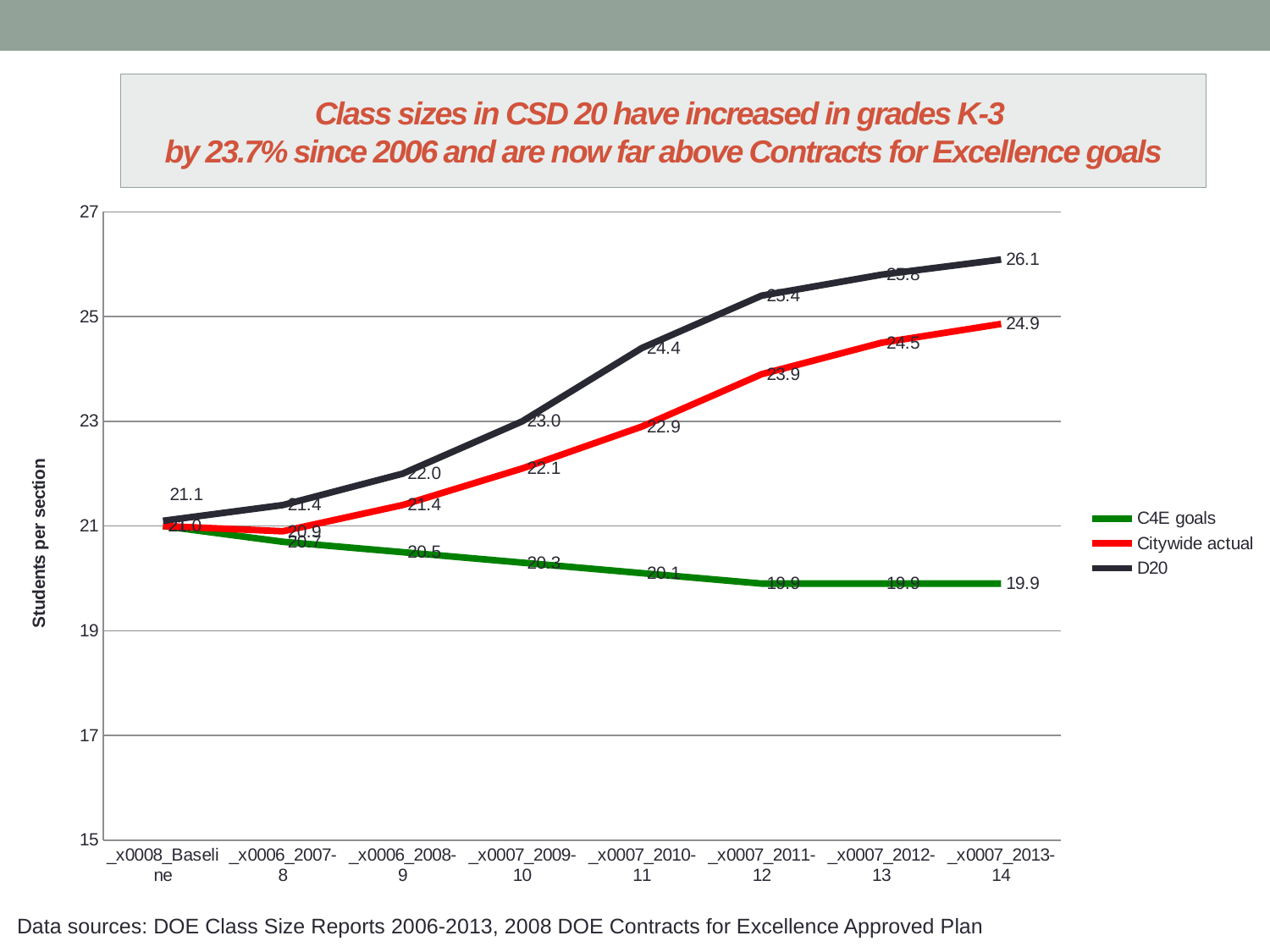
What is the D20 value for 2010-11? 24.4 What is the Citywide actual value for 2013-14? 24.9 What is the difference between the D20 value and the C4E goals value in 2013-14? 6.2 What is the D20 value at the Baseline point? 21.1 What is the C4E goals value for 2013-14? 19.9 What is the D20 value for 2013-14? 26.1 How many series does the legend list? 3 Which series has the highest value in 2013-14? D20 Does the D20 line rise or fall from Baseline to 2013-14? rise How many time points are plotted along the x axis? 8 What kind of chart is shown on the slide? line chart What is the label on the y axis? Students per section